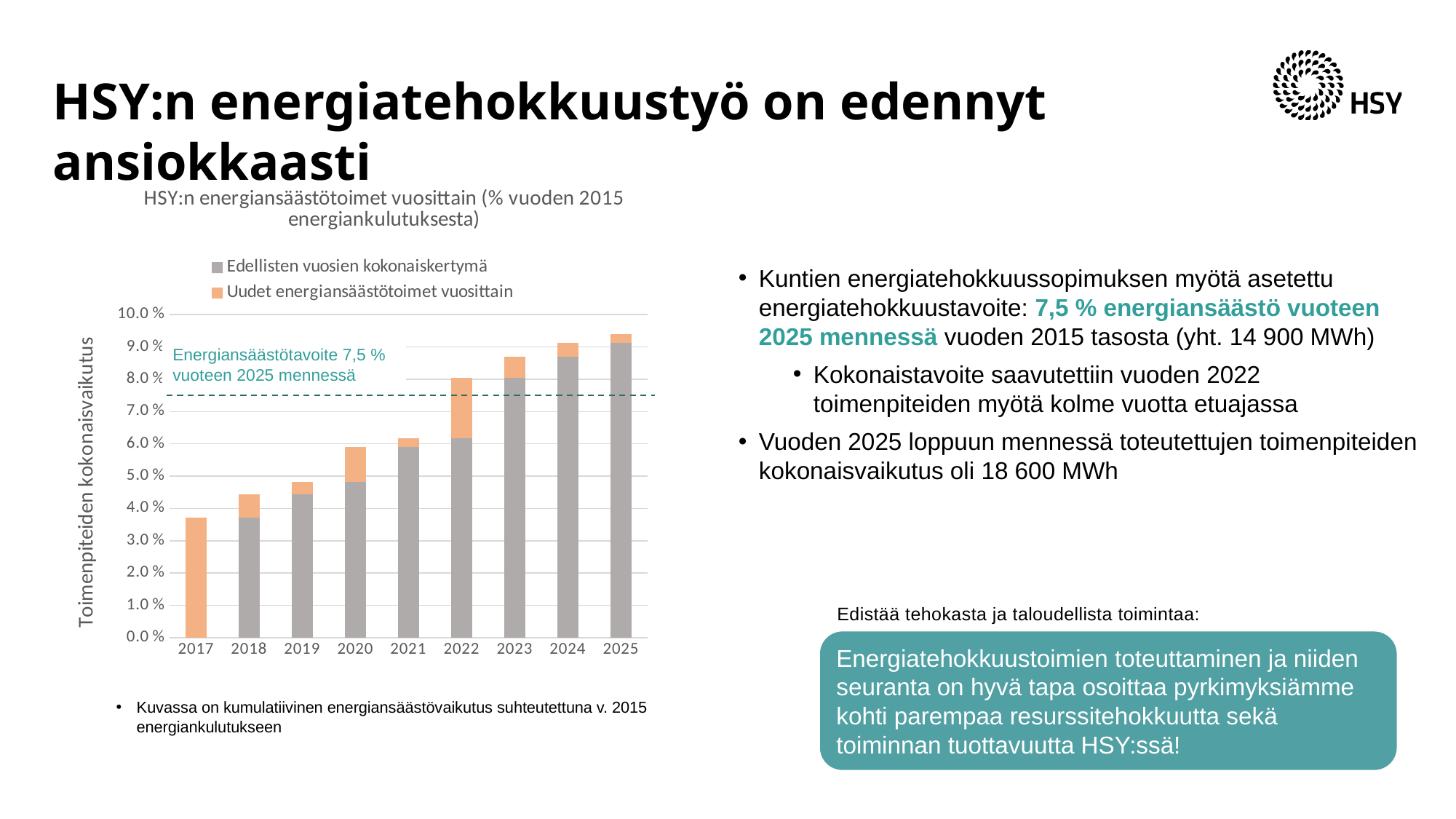
Is the total bar for 2023 greater or less than 8.0 %? greater Which year has the lowest total bar in the chart? 2017 Which year has the highest total bar in the chart? 2025 Do the total bar heights rise or fall from 2017 to 2025? Rise What kind of chart is shown on the slide? Stacked bar chart What energy saving target does the dashed horizontal line in the chart mark? 7,5 % vuoteen 2025 mennessä Is the total bar for 2025 greater or less than 9.0 %? greater Is the total bar for 2019 greater or less than 5.0 %? less Which year has a larger total bar, 2017 or 2025? 2025 How many years are shown on the x axis of the chart? 9 How many series does the chart's legend list? 2